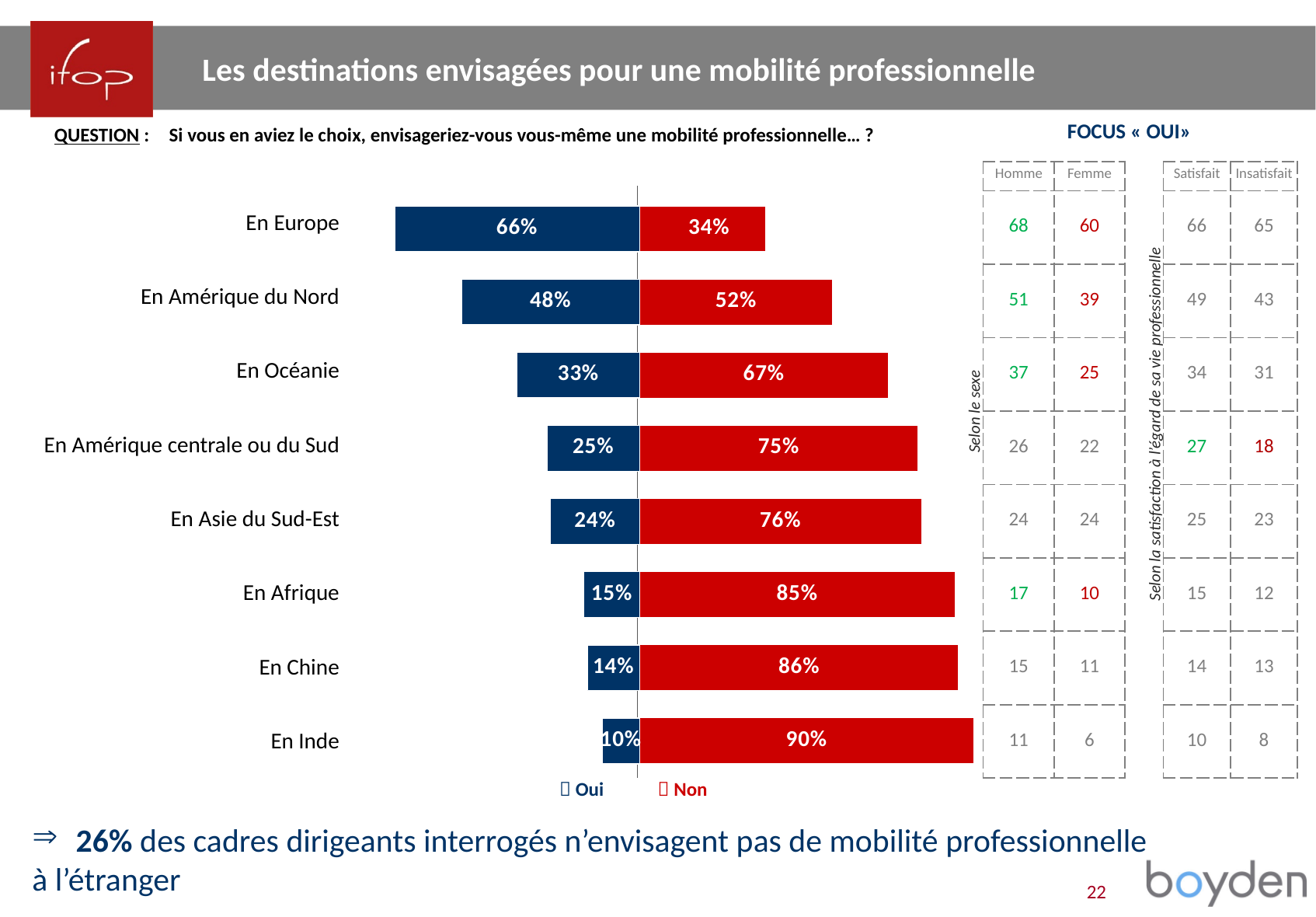
What kind of chart is shown on the slide? Bar chart How many destinations are shown in the bar chart? 8 Which destination has the highest "Oui" value? En Europe Which destination has the highest "Non" value? En Inde What is the "Non" value for En Chine? 86% Which has a larger "Oui" value, En Amérique du Nord or En Océanie? En Amérique du Nord What are the two legend entries of the chart? Oui and Non What is the "Oui" value for En Asie du Sud-Est? 24% What is the difference between the "Non" and "Oui" values for En Océanie? 34% Which destination has the lowest "Oui" value? En Inde How many series does the chart legend list? 2 What is the "Oui" value for En Europe? 66%